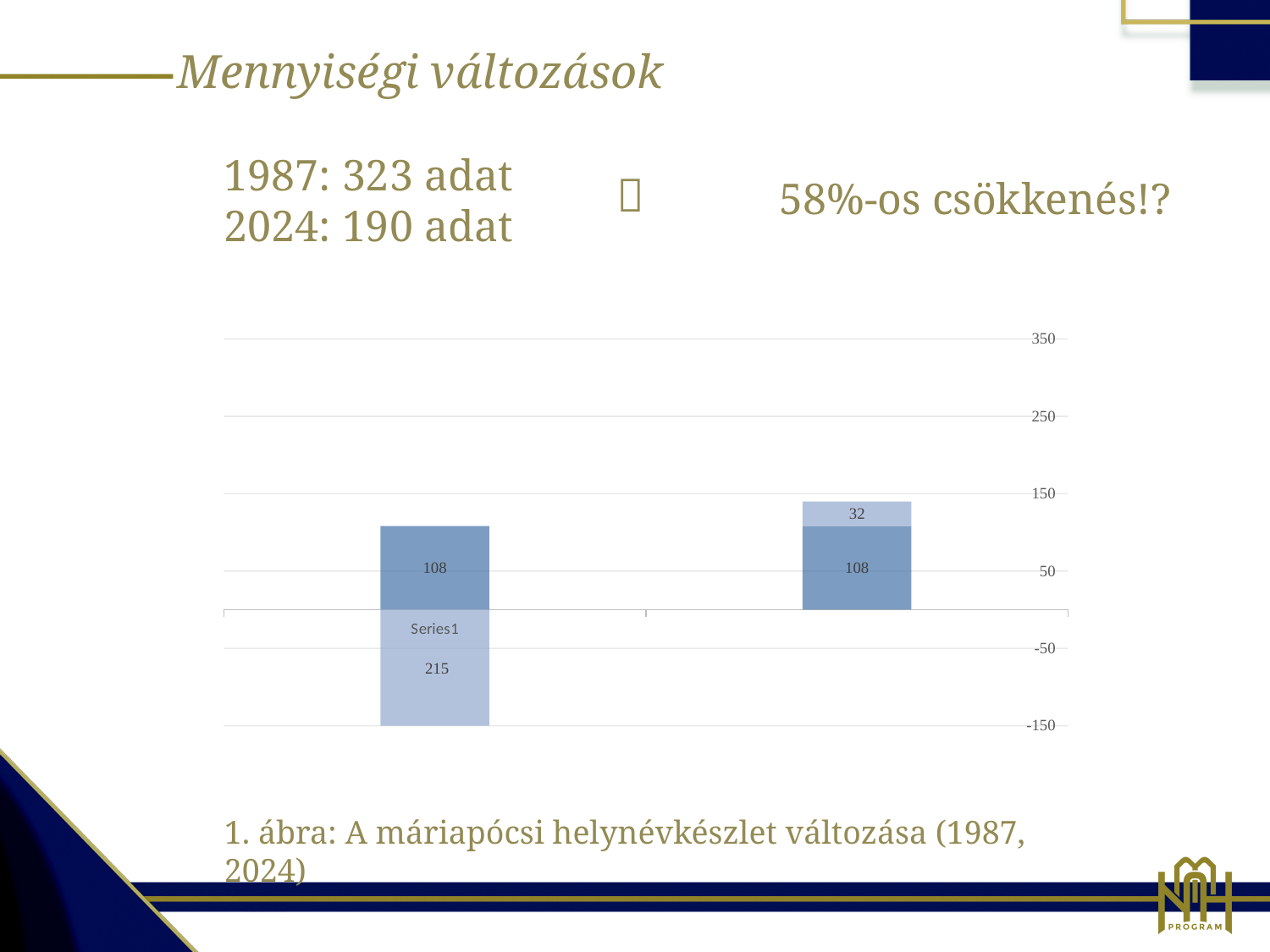
Is the top of the right stacked bar greater or less than 150 on the vertical axis? less Which bar has the larger light blue segment value, the left bar or the right bar? left bar What is the difference between the light blue segment values of the left bar (215) and the right bar (32)? 183 What is the value printed on the light blue segment of the left bar, which extends below the horizontal axis? 215 What is the value of the light blue segment on top of the right bar? 32 What is the value of the dark blue segment of the left bar? 108 What kind of chart is shown on the slide? bar chart What is the total of the two stacked segments of the right bar? 140 What is the highest tick value shown on the vertical axis? 350 How many stacked bars are plotted in the chart? 2 What is the caption given below the chart? 1. ábra: A máriapócsi helynévkészlet változása (1987, 2024) What is the value of the dark blue segment of the right bar? 108